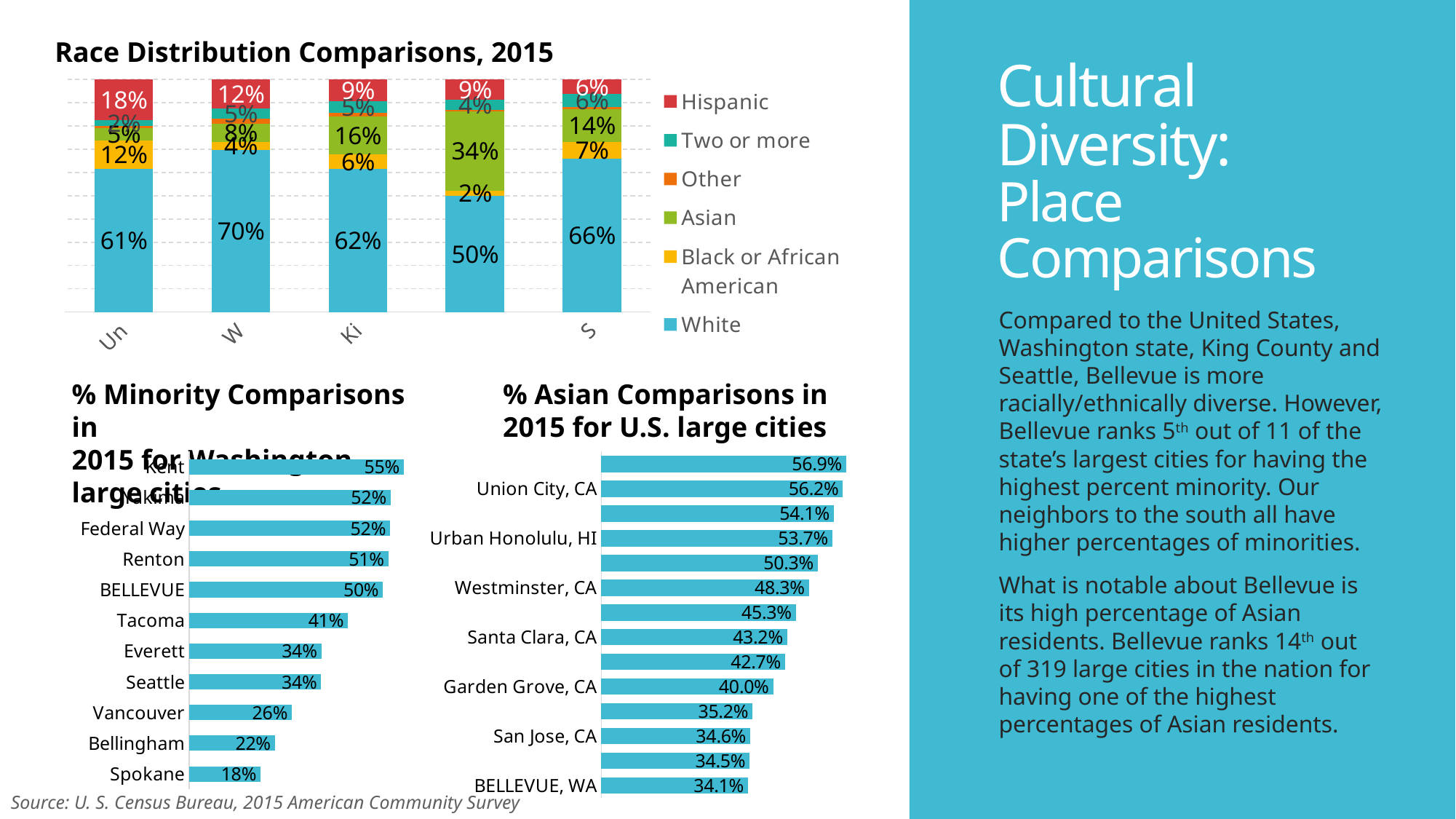
In the '% Minority Comparisons in 2015 for Washington large cities' chart, what is the value for BELLEVUE? 50% In the '% Asian Comparisons in 2015 for U.S. large cities' chart, what is the value for Union City, CA? 56.2% In the '% Minority Comparisons in 2015 for Washington large cities' chart, what is the difference between Tacoma and Spokane? 23% How many cities are shown in the '% Minority Comparisons in 2015 for Washington large cities' chart? 11 What kind of chart is the '% Asian Comparisons in 2015 for U.S. large cities' chart? Bar chart In the '% Minority Comparisons in 2015 for Washington large cities' chart, which city has the lowest value? Spokane In the '% Asian Comparisons in 2015 for U.S. large cities' chart, what is the value for BELLEVUE, WA? 34.1% How many series does the legend of the 'Race Distribution Comparisons, 2015' chart list? 6 In the 'Race Distribution Comparisons, 2015' chart, what is the highest White percentage shown on any bar? 70% In the '% Minority Comparisons in 2015 for Washington large cities' chart, what is the value for Federal Way? 52% In the '% Asian Comparisons in 2015 for U.S. large cities' chart, what is the difference between Westminster, CA and San Jose, CA? 13.7% In the '% Minority Comparisons in 2015 for Washington large cities' chart, which is larger, Renton or Everett? Renton